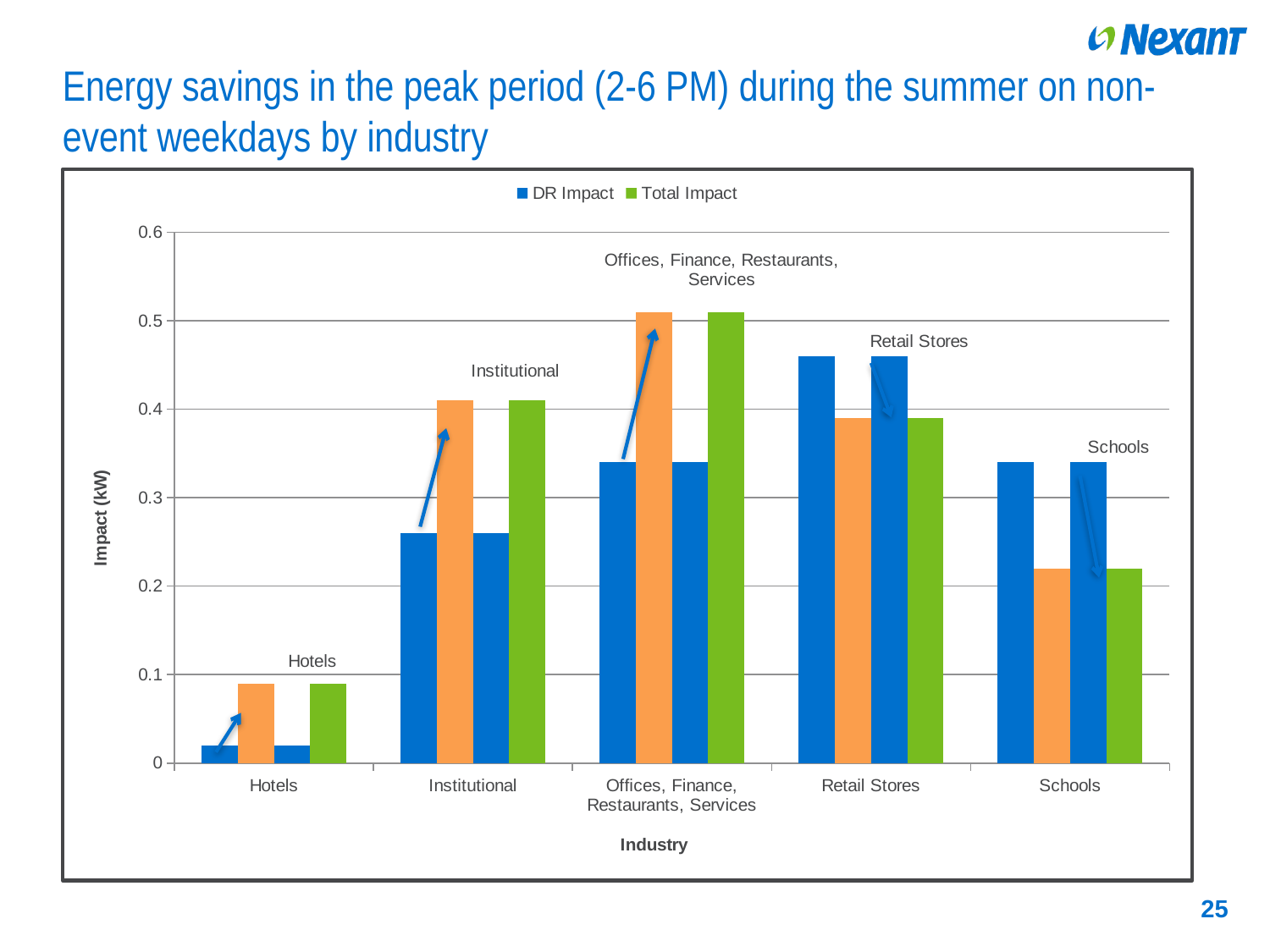
For Retail Stores, which is larger: DR Impact or Total Impact? DR Impact What is the label of the y axis? Impact (kW) Is the DR Impact value for Institutional greater or less than 0.3? less How many industry categories are shown on the x axis? 5 What kind of chart is shown on the slide? bar chart Is the DR Impact value for Retail Stores greater or less than 0.4? greater For Institutional, which is larger: DR Impact or Total Impact? Total Impact Which industry has the highest DR Impact? Retail Stores Is the Total Impact value for Hotels greater or less than 0.1? less Which industry has the lowest DR Impact? Hotels How many series does the legend list? 2 Which industry has the highest Total Impact? Offices, Finance, Restaurants, Services